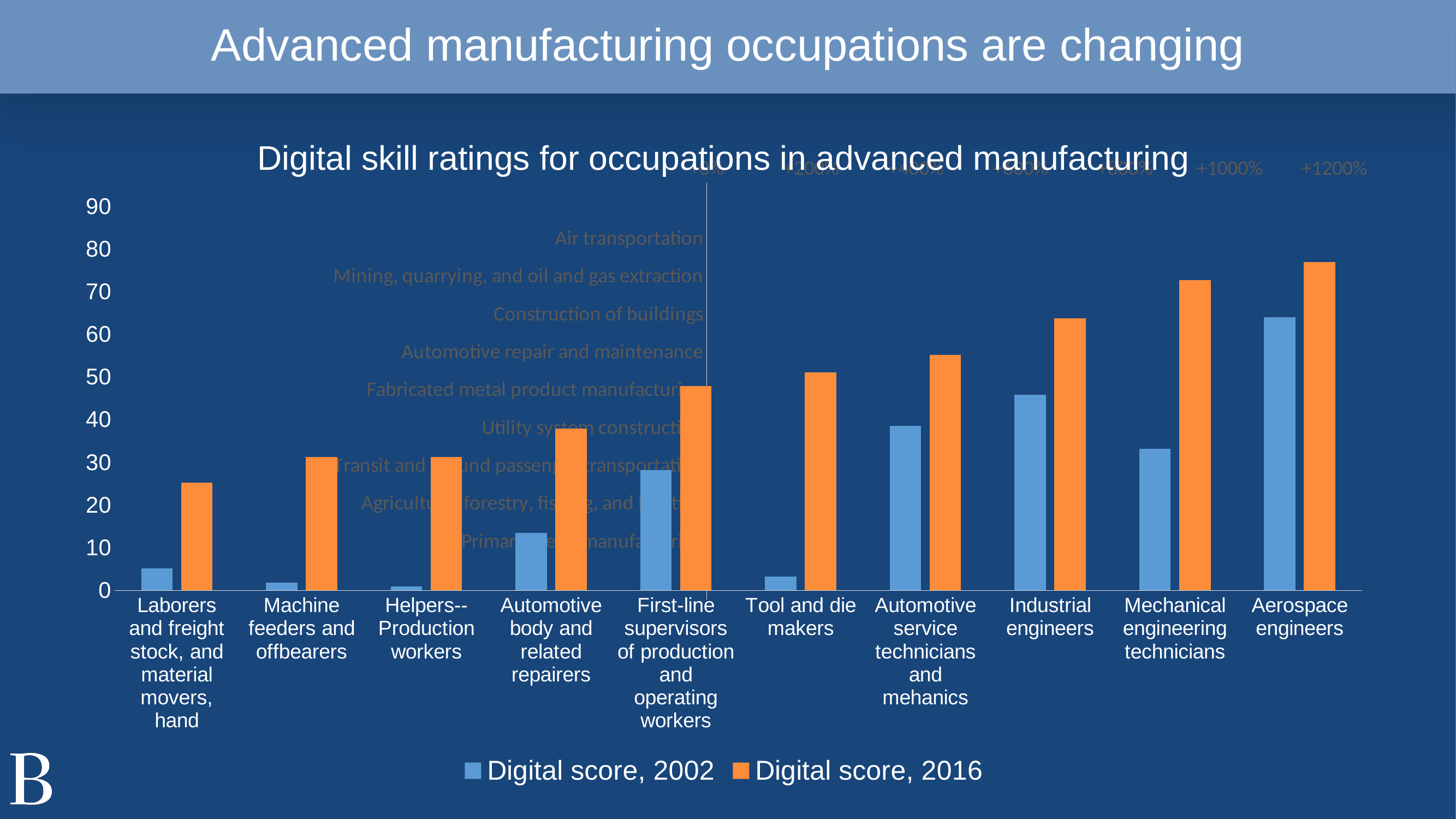
How many occupations are shown on the x axis? 10 Which colour represents Digital score, 2016 in the legend? Orange Is the Digital score, 2002 for Laborers and freight stock, and material movers, hand greater or less than 10? less Do the Digital score, 2016 values generally rise or fall from left to right across the occupations? rise Is the Digital score, 2016 for Tool and die makers greater or less than 40? greater Which occupation has the highest Digital score, 2002? Aerospace engineers Is the Digital score, 2016 for Mechanical engineering technicians greater or less than 70? greater What kind of chart is shown on the slide? Bar chart How many series does the legend list? 2 Which is larger: the Digital score, 2016 for Industrial engineers or for Mechanical engineering technicians? Mechanical engineering technicians Which occupation has the highest Digital score, 2016? Aerospace engineers